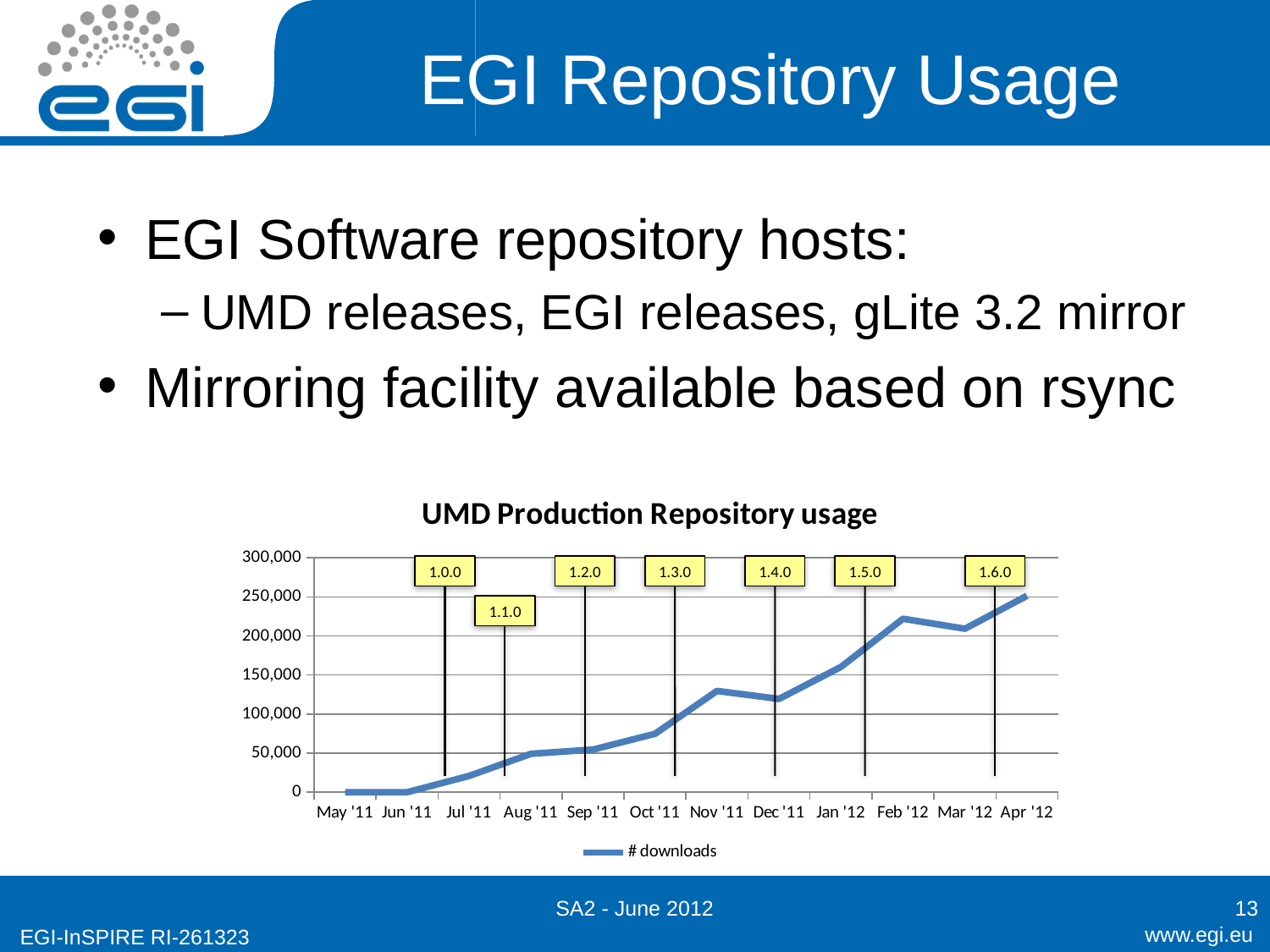
Is the value for Nov '11 greater or less than 100,000? greater Which month has the highest number of downloads? Apr '12 How many months are plotted along the x axis? 12 Is the value for Feb '12 greater or less than 200,000? greater What is the title of the chart? UMD Production Repository usage Is the value for Jul '11 greater or less than 50,000? less What is the name of the series shown in the legend? # downloads What kind of chart is shown on the slide? line chart How many series does the chart legend list? 1 Do the download values generally rise or fall from May '11 to Apr '12? rise Which has more downloads, Dec '11 or Feb '12? Feb '12